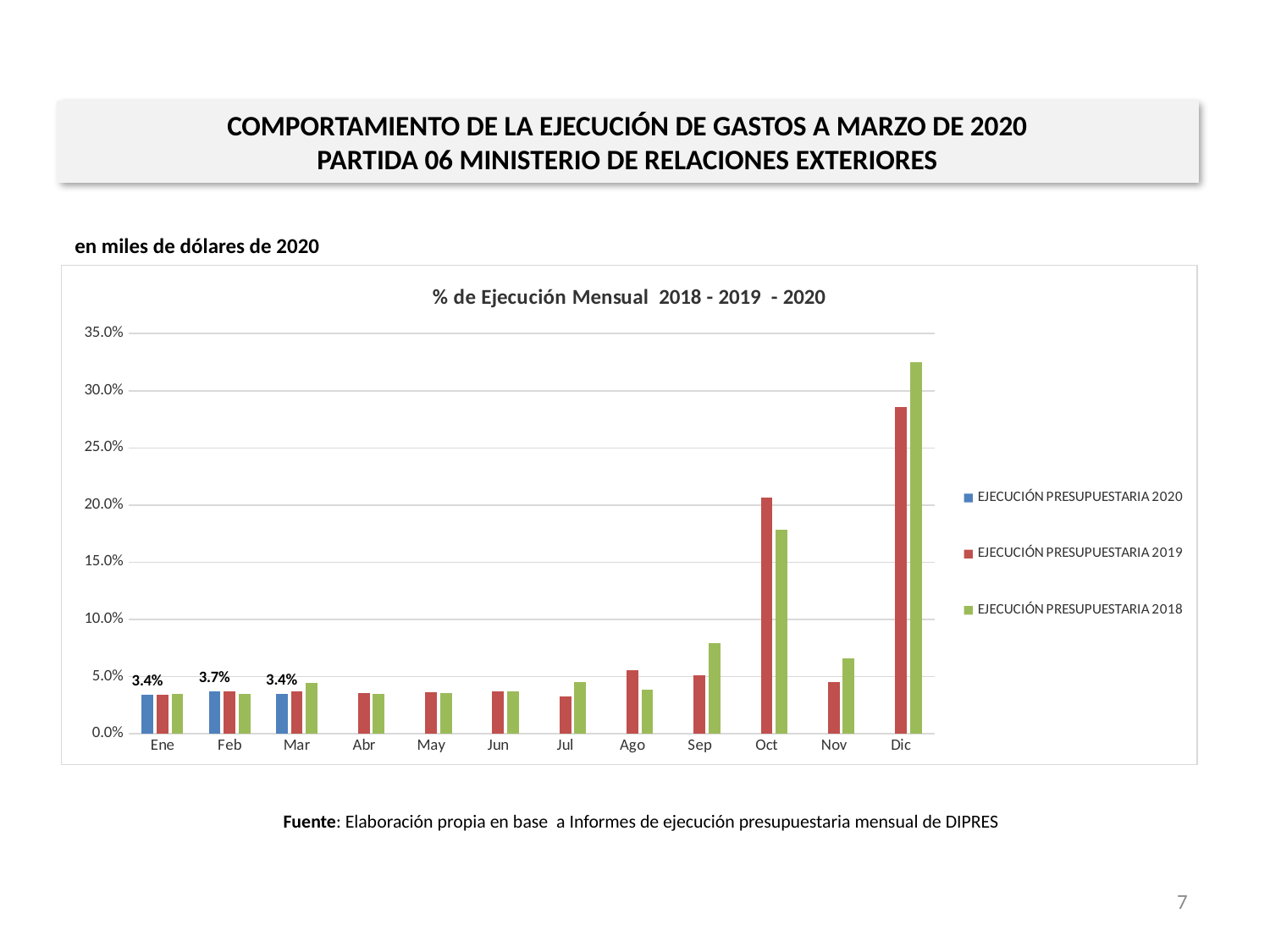
Among the months with data labels, which month has the highest value for EJECUCIÓN PRESUPUESTARIA 2020? Feb What is the value for EJECUCIÓN PRESUPUESTARIA 2020 in Feb? 3.7% Is the value for EJECUCIÓN PRESUPUESTARIA 2018 in Dic greater or less than 30.0%? greater What is the difference between the EJECUCIÓN PRESUPUESTARIA 2020 values for Feb and Ene? 0.3% Is the value for EJECUCIÓN PRESUPUESTARIA 2019 in Oct greater or less than 15.0%? greater What is the value for EJECUCIÓN PRESUPUESTARIA 2020 in Ene? 3.4% Which month has the highest value for EJECUCIÓN PRESUPUESTARIA 2019? Dic Which is larger in Oct: EJECUCIÓN PRESUPUESTARIA 2019 or EJECUCIÓN PRESUPUESTARIA 2018? EJECUCIÓN PRESUPUESTARIA 2019 How many series does the legend list? 3 Which month has the highest value for EJECUCIÓN PRESUPUESTARIA 2018? Dic What is the value for EJECUCIÓN PRESUPUESTARIA 2020 in Mar? 3.4% How many months are shown on the x axis of the chart? 12